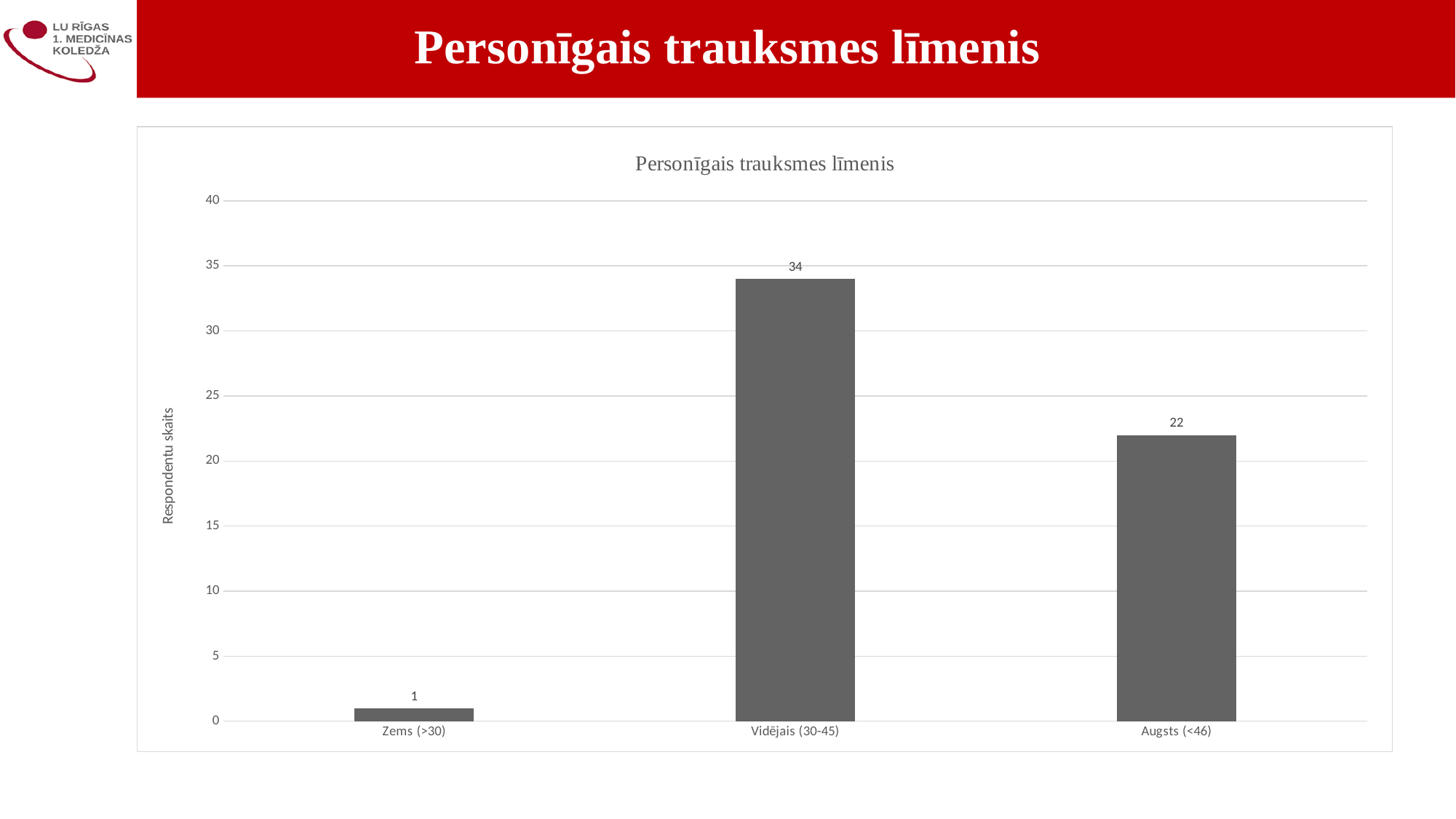
What is the label of the vertical axis? Respondentu skaits Is the value for Vidējais (30-45) greater or less than 30? greater What is the difference between the values for Vidējais (30-45) and Augsts (<46)? 12 What is the value for Augsts (<46)? 22 What is the value for Vidējais (30-45)? 34 How many categories are shown on the x axis? 3 What is the value for Zems (>30)? 1 Which category has the highest value? Vidējais (30-45) Which is larger, the value for Augsts (<46) or the value for Zems (>30)? Augsts (<46) What is the difference between the values for Augsts (<46) and Zems (>30)? 21 What kind of chart is shown on the slide? bar chart Which category has the lowest value? Zems (>30)